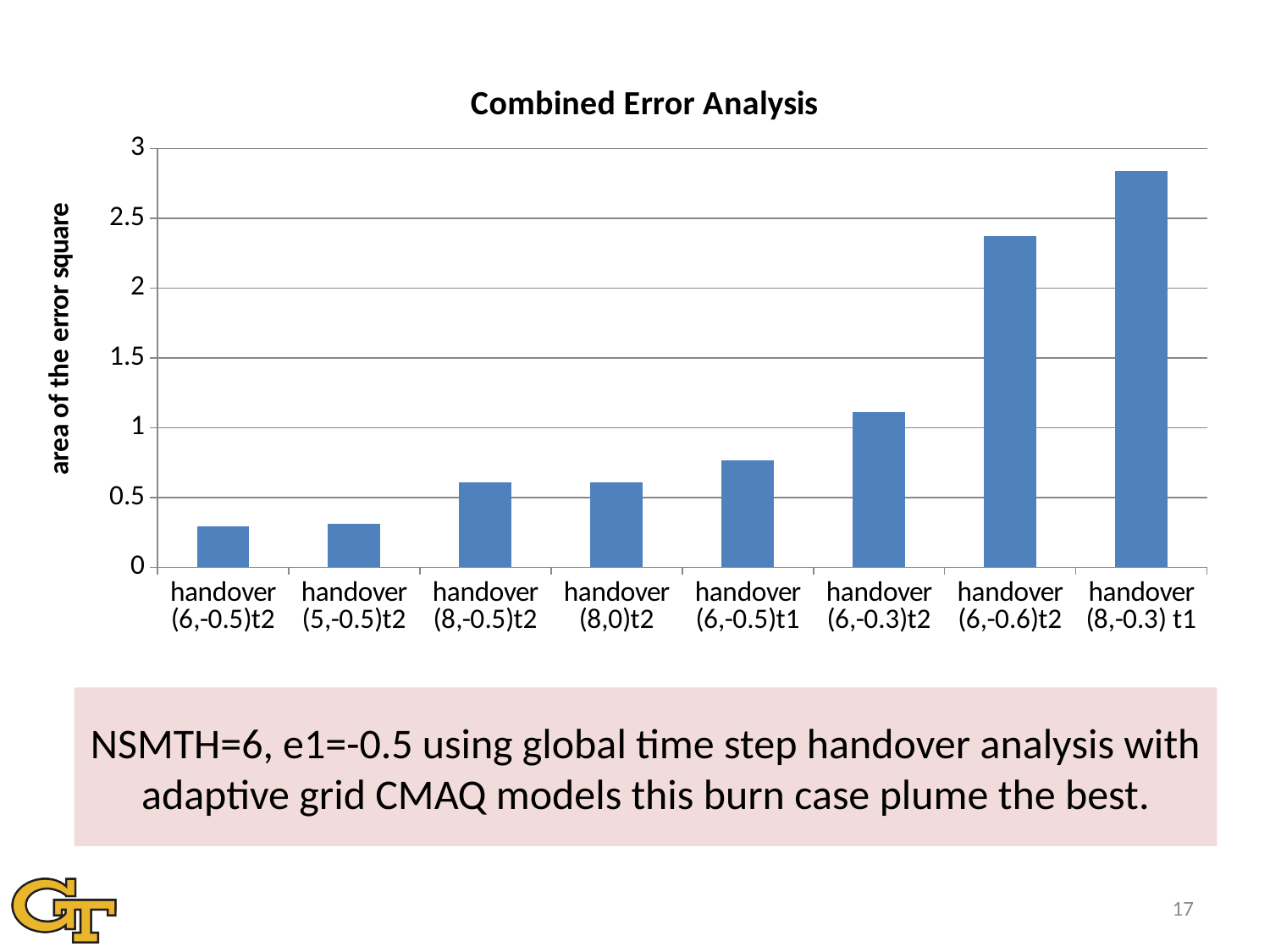
Do the values generally rise or fall moving from left to right along the x axis? rise Which category has the highest value? handover (8,-0.3) t1 Is the value for handover (6,-0.3)t2 greater or less than 1? greater Which is larger, the value for handover (6,-0.6)t2 or handover (8,-0.3) t1? handover (8,-0.3) t1 Is the value for handover (8,-0.3) t1 greater or less than 2.5? greater What is the title of the chart? Combined Error Analysis Is the value for handover (6,-0.6)t2 greater or less than 2? greater How many categories (bars) are plotted in the chart? 8 What type of chart is shown on the slide? bar chart What is the label of the vertical axis? area of the error square